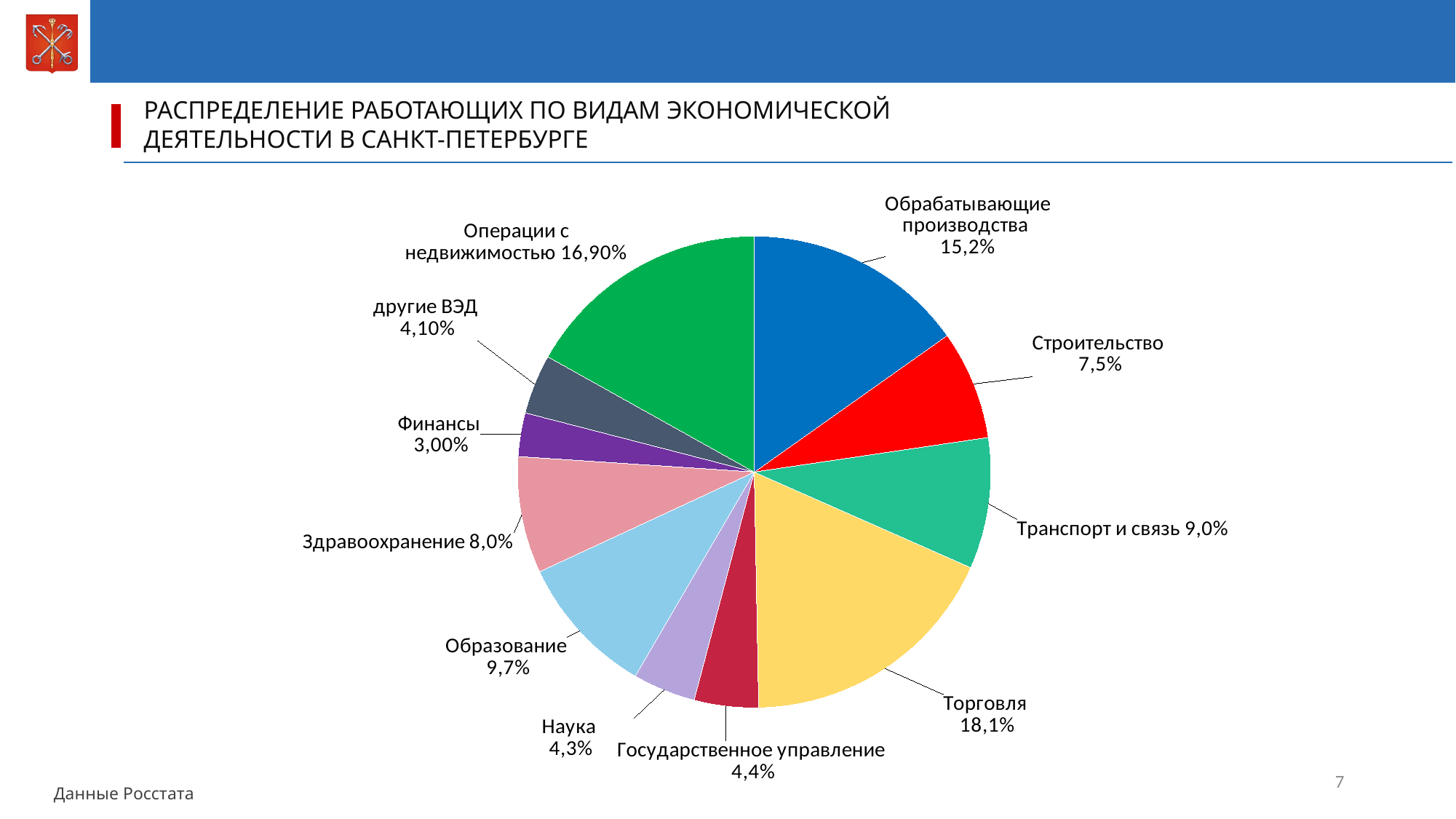
Which has a larger share: Строительство or Здравоохранение? Здравоохранение How many sectors (slices) are shown in the pie chart? 11 What share of workers is in Финансы? 3,00% What is the title of the chart on the slide? РАСПРЕДЕЛЕНИЕ РАБОТАЮЩИХ ПО ВИДАМ ЭКОНОМИЧЕСКОЙ ДЕЯТЕЛЬНОСТИ В САНКТ-ПЕТЕРБУРГЕ Which sector has the largest share of workers? Торговля Which sector has the smallest share of workers? Финансы What share of workers is in Торговля? 18,1% What share of workers is in Образование? 9,7% What is the difference between the shares of Торговля and Обрабатывающие производства? 2,9% What share of workers is in Операции с недвижимостью? 16,90% What share of workers is in Обрабатывающие производства? 15,2% What type of chart is shown on the slide? Pie chart